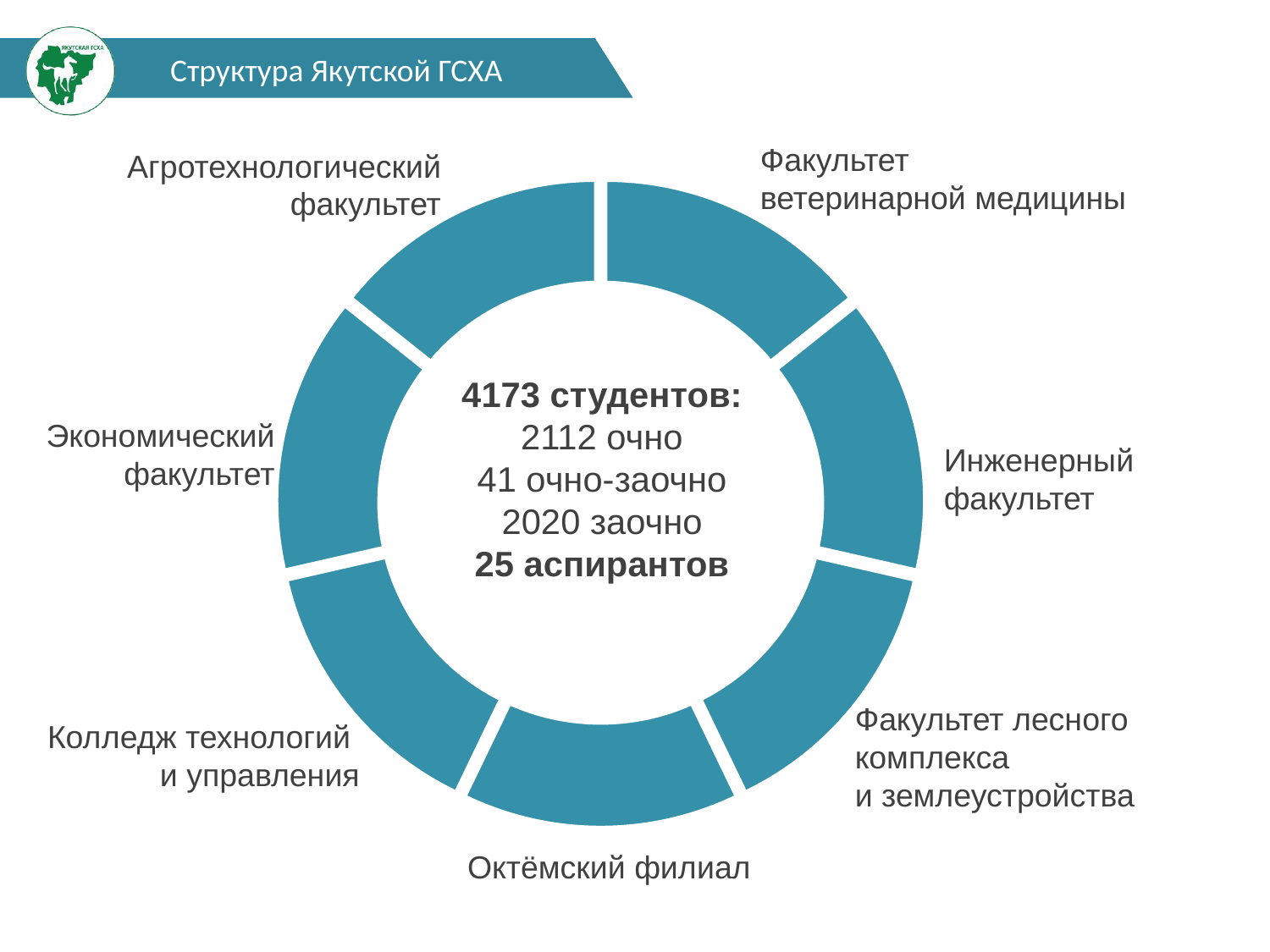
How many full-time (очно) students are shown in the centre of the chart? 2112 How many postgraduate students (аспирантов) are shown in the centre of the chart? 25 Which segment label is placed to the right of the donut chart, in the middle? Инженерный факультет What is the title of the slide containing the chart? Структура Якутской ГСХА How many segments (faculties/units) does the donut chart have? 7 What is the total number of students shown in the centre of the chart? 4173 студентов How many part-time (очно-заочно) students are shown in the centre of the chart? 41 What is the difference between the number of full-time (очно) and correspondence (заочно) students? 92 How many correspondence (заочно) students are shown in the centre of the chart? 2020 What kind of chart is shown on the slide? Pie (donut) chart Which segment label is placed directly below the donut chart? Октёмский филиал Which is larger: the number of full-time (очно) students or correspondence (заочно) students? очно (2112)